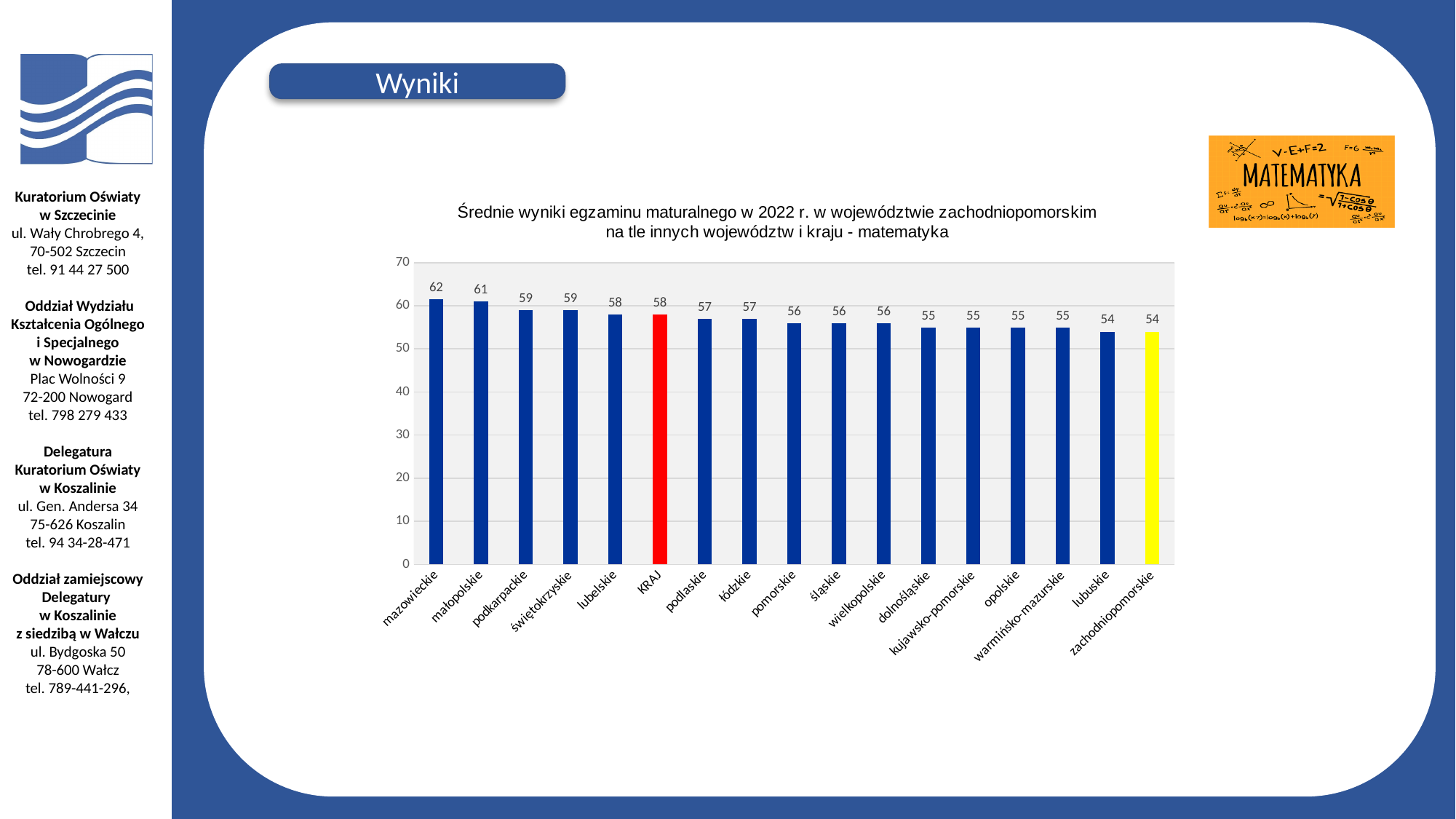
What is the lowest value shown on the chart? 54 What is the value for KRAJ? 58 Which category has the highest value? mazowieckie What is the difference between the values for mazowieckie and zachodniopomorskie? 8 What kind of chart is shown on the slide? bar chart Which is larger, the value for małopolskie or the value for lubelskie? małopolskie What is the value for zachodniopomorskie? 54 What is the value for mazowieckie? 62 How many bars are shown on the chart? 17 What is the difference between the values for KRAJ and zachodniopomorskie? 4 Do the values rise or fall from left to right along the x axis? fall What is the value for pomorskie? 56